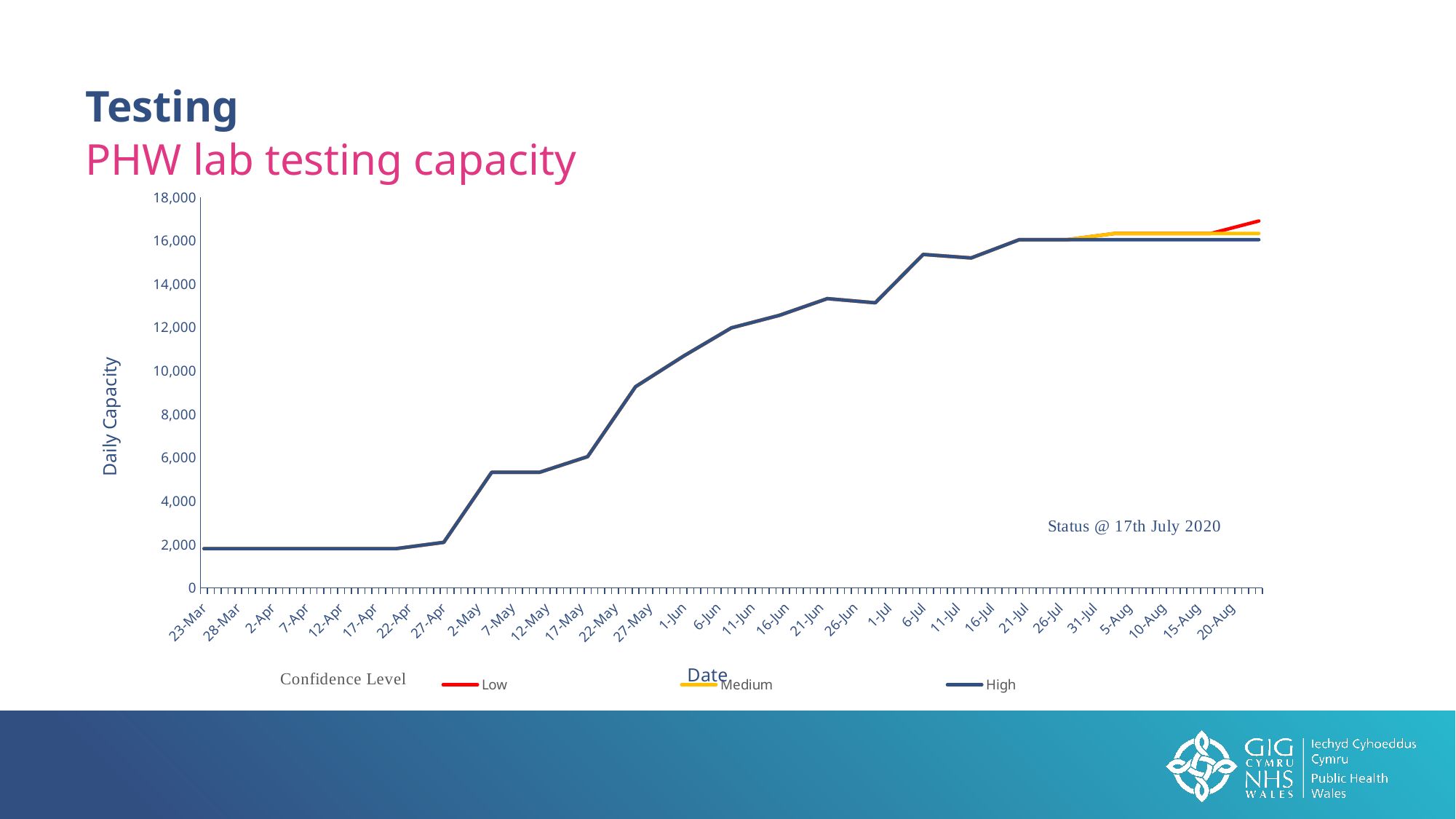
Does the daily capacity generally rise or fall from 23-Mar to 20-Aug? rise Is the daily capacity on 6-Jul greater or less than 14,000? greater Is the daily capacity on 27-May greater or less than 10,000? less Is the daily capacity on 23-Mar greater or less than 4,000? less What kind of chart is shown on the slide? line chart What is the title of the legend on the chart? Confidence Level How many series does the legend list? 3 What is the label on the vertical axis of the chart? Daily Capacity Which confidence level series shows the highest value on 20-Aug? Low